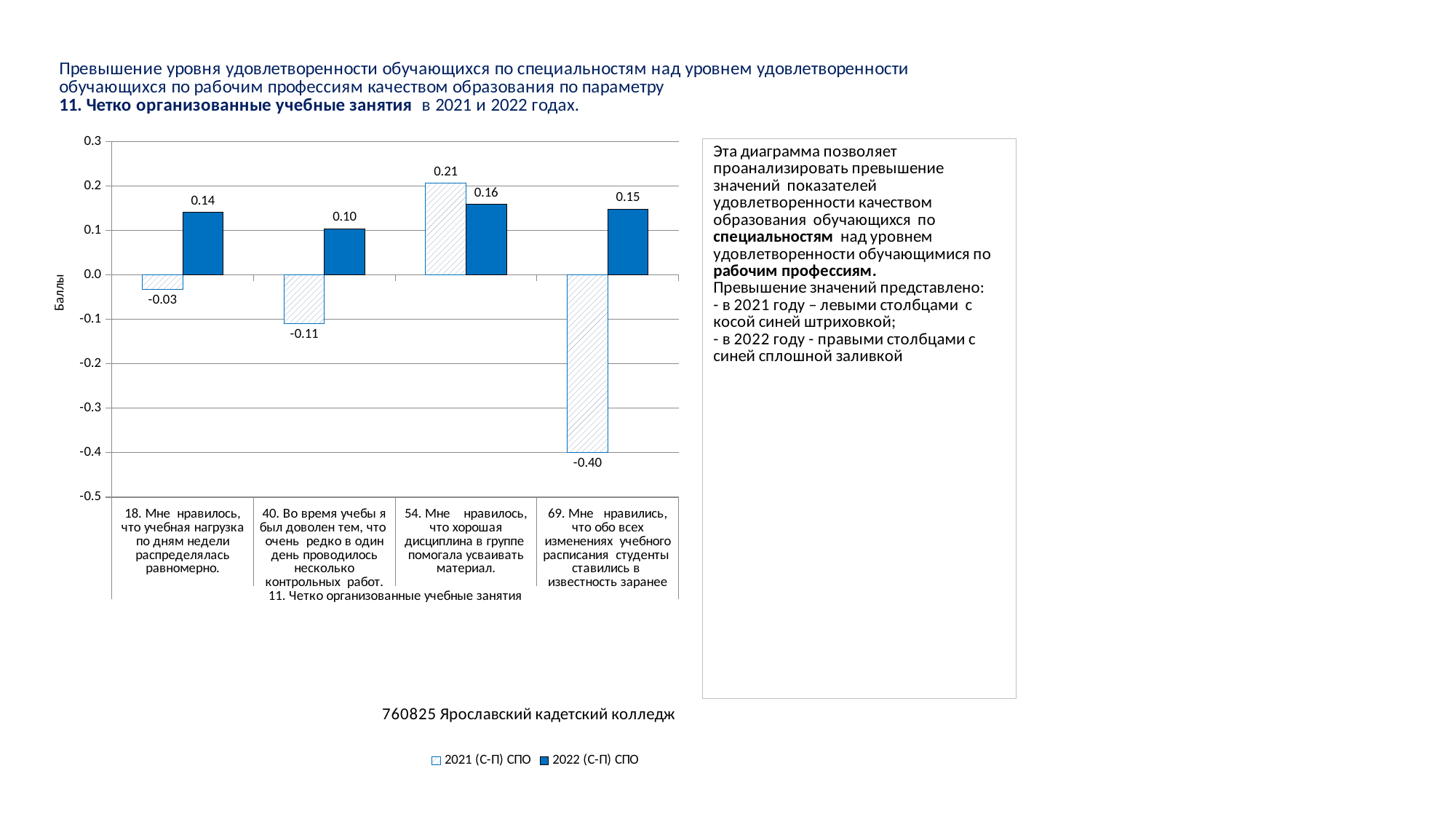
What is the difference between the 2021 and 2022 (С-П) СПО values for category 54? 0.05 What is the 2021 (С-П) СПО value for category 18 ("Мне нравилось, что учебная нагрузка по дням недели распределялась равномерно")? -0.03 How many categories are shown on the x axis of the chart? 4 How many series does the chart legend list? 2 What is the 2022 (С-П) СПО value for category 40 ("Во время учебы я был доволен тем, что очень редко в один день проводилось несколько контрольных работ")? 0.10 Is the 2021 (С-П) СПО value for category 69 greater or less than -0.3? less For category 18, which series has the larger value: 2021 (С-П) СПО or 2022 (С-П) СПО? 2022 (С-П) СПО Which category has the highest 2022 (С-П) СПО value? 54. Мне нравилось, что хорошая дисциплина в группе помогала усваивать материал. Which category has the lowest 2021 (С-П) СПО value? 69. Мне нравились, что обо всех изменениях учебного расписания студенты ставились в известность заранее What is the label of the vertical axis of the chart? Баллы What is the 2021 (С-П) СПО value for category 69 ("Мне нравились, что обо всех изменениях учебного расписания студенты ставились в известность заранее")? -0.40 What type of chart is shown on the slide? Bar chart